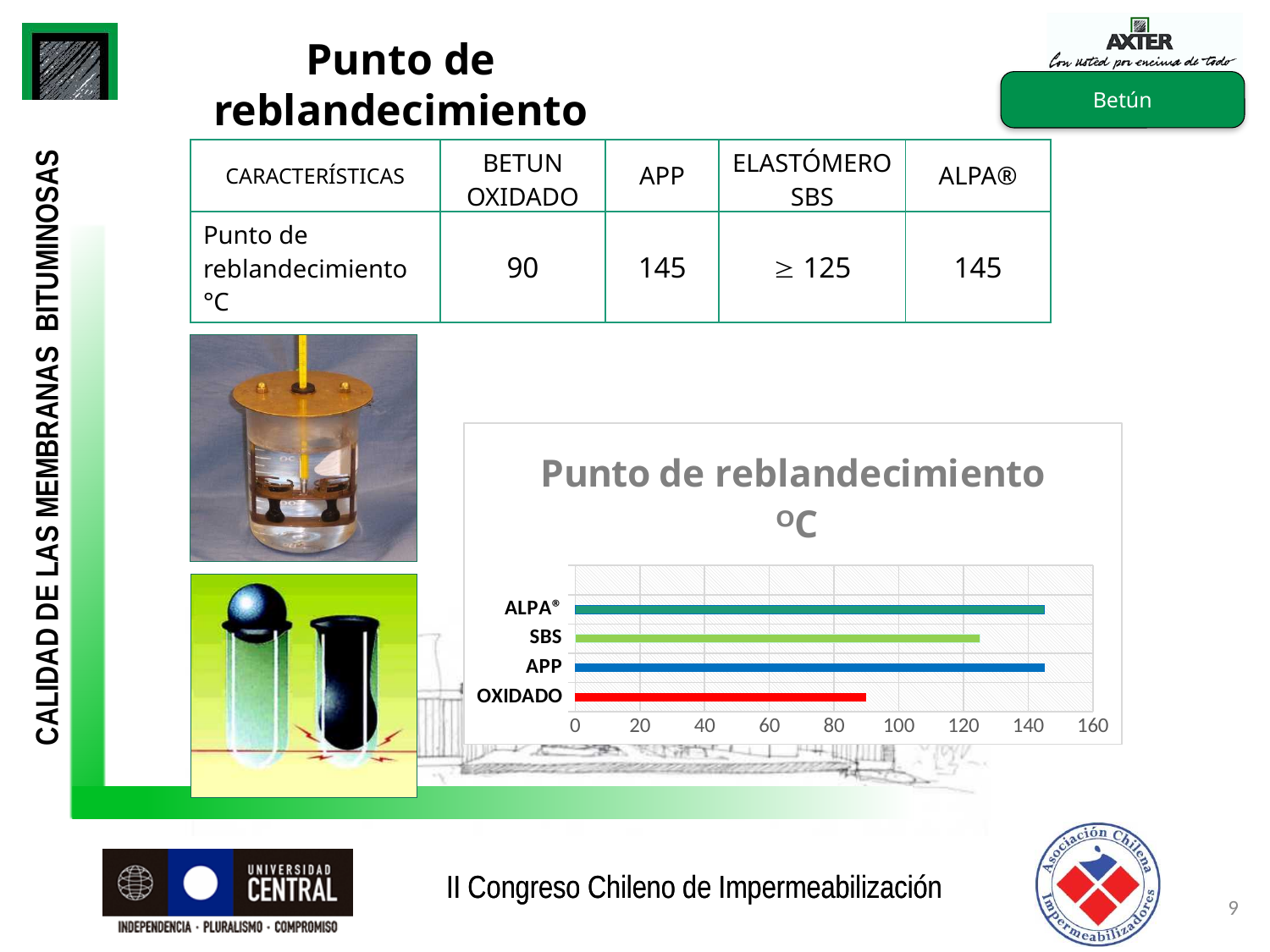
Is the value for APP greater or less than 140? greater How many categories are plotted in the chart? 4 Is the value for SBS greater or less than 140? less Is the value for OXIDADO greater or less than 80? greater What kind of chart is shown on the slide? bar chart What is the title of the chart? Punto de reblandecimiento ºC Which is larger, the value for SBS or the value for OXIDADO? SBS Which category has the lowest value in the chart? OXIDADO Which is larger, the value for APP or the value for SBS? APP